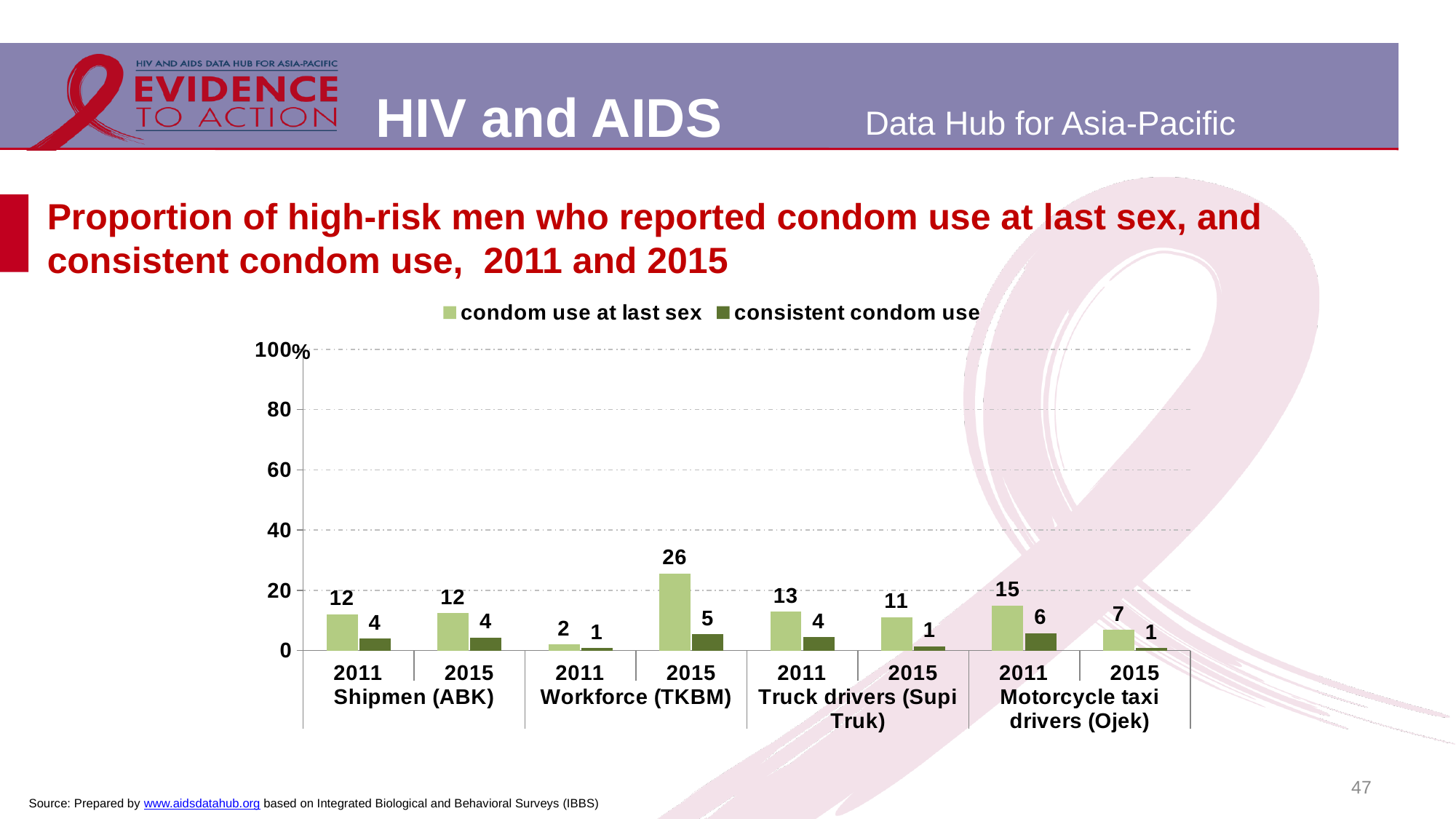
What is the value for consistent condom use among Motorcycle taxi drivers (Ojek) in 2011? 6 How many high-risk groups are shown on the x axis? 4 What is the difference between condom use at last sex and consistent condom use for Shipmen (ABK) in 2015? 8 Which is larger: condom use at last sex for Motorcycle taxi drivers (Ojek) in 2011 or in 2015? 2011 What is the value for condom use at last sex among Truck drivers (Supi Truk) in 2011? 13 What is the value for condom use at last sex among Workforce (TKBM) in 2015? 26 What is the difference between condom use at last sex for Workforce (TKBM) in 2015 and in 2011? 24 How many series does the legend list? 2 Is the value for condom use at last sex among Workforce (TKBM) in 2015 greater or less than 20? greater What kind of chart is shown on the slide? bar chart Which group and year has the lowest value for condom use at last sex? Workforce (TKBM) 2011 Which group and year has the highest value for condom use at last sex? Workforce (TKBM) 2015